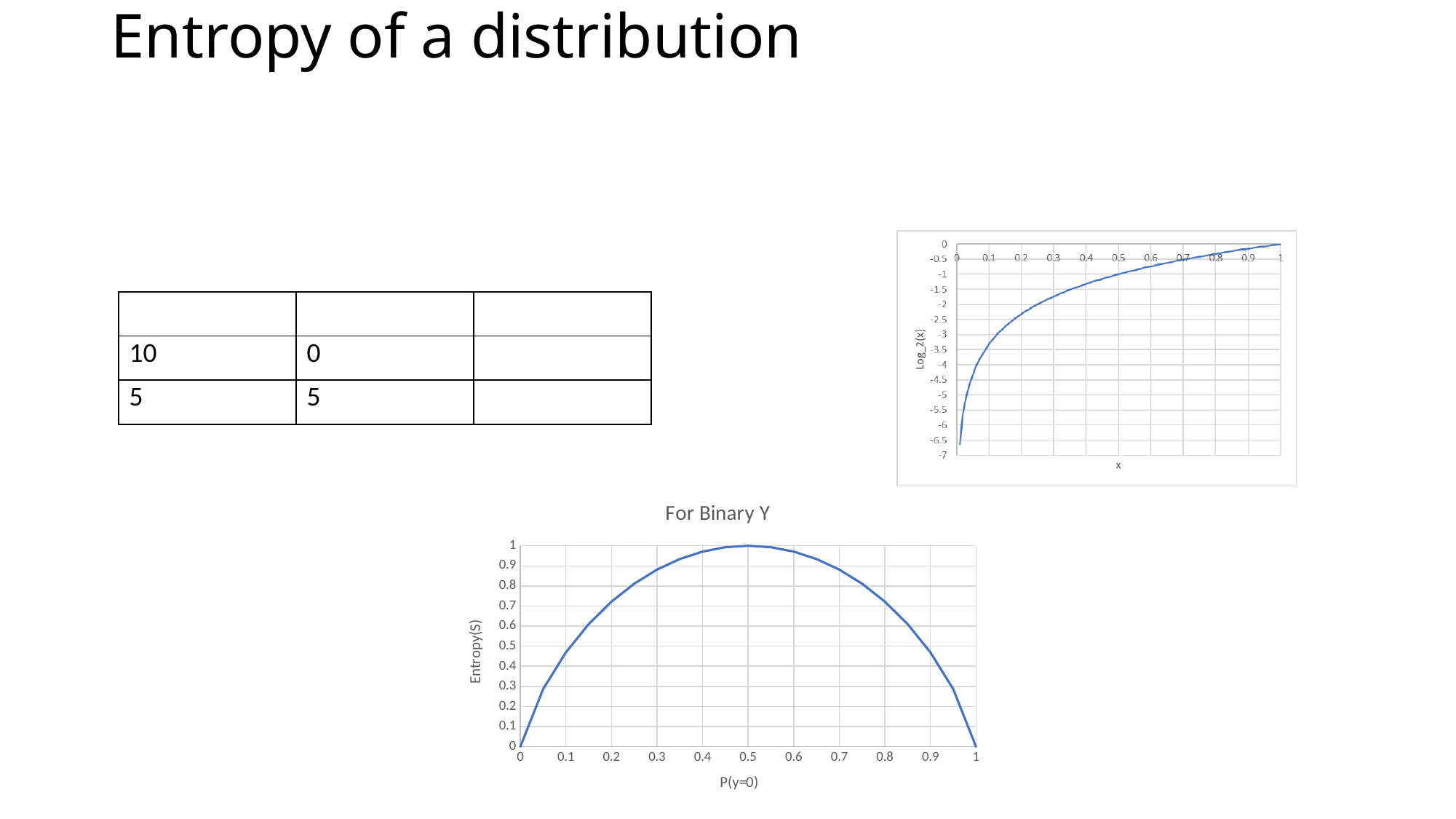
In the "For Binary Y" chart, what is the value of Entropy(S) when P(y=0) is 0.5? 1 In the top-right Log_2(x) chart, what is the value of Log_2(x) when x is 1? 0 In the "For Binary Y" chart, what is the title of the chart? For Binary Y In the "For Binary Y" chart, at which value of P(y=0) is Entropy(S) highest? 0.5 In the "For Binary Y" chart, what is the value of Entropy(S) when P(y=0) is 1? 0 In the "For Binary Y" chart, what is the value of Entropy(S) when P(y=0) is 0? 0 In the top-right Log_2(x) chart, is the value of Log_2(x) at x = 0.1 greater or less than -2? less What kind of chart is the chart in the top right with y axis Log_2(x)? line chart In the "For Binary Y" chart, does Entropy(S) rise or fall as P(y=0) increases from 0.5 to 1? fall What kind of chart is the "For Binary Y" chart? line chart In the "For Binary Y" chart, is the value of Entropy(S) at P(y=0) = 0.2 greater or less than 0.5? greater In the "For Binary Y" chart, what is the x-axis label? P(y=0)